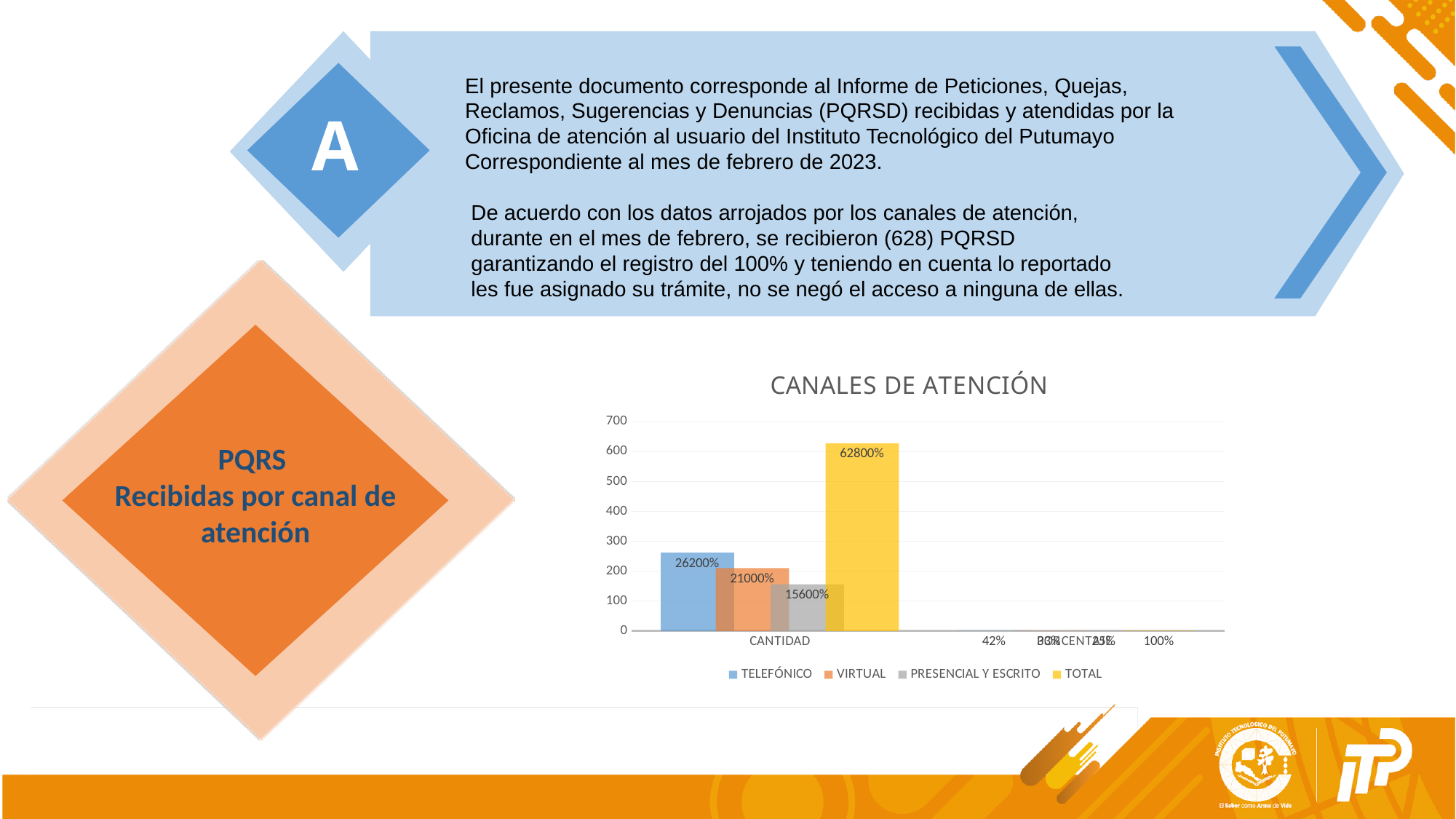
What is the data label shown for PRESENCIAL Y ESCRITO in the CANTIDAD group? 15600% What is the data label shown for VIRTUAL in the CANTIDAD group? 21000% What kind of chart is shown on the slide? bar chart Is the TOTAL bar in the CANTIDAD group greater or less than 600 on the axis? greater How many series does the chart legend list? 4 What is the title of the chart? CANALES DE ATENCIÓN In the CANTIDAD group, which bar is taller: TELEFÓNICO or VIRTUAL? TELEFÓNICO What is the data label shown for TOTAL in the CANTIDAD group? 62800% Which colour represents the TOTAL series in the legend? yellow Which series has the shortest bar in the CANTIDAD group? PRESENCIAL Y ESCRITO What is the data label shown for TELEFÓNICO in the CANTIDAD group? 26200% Which series has the tallest bar in the CANTIDAD group? TOTAL